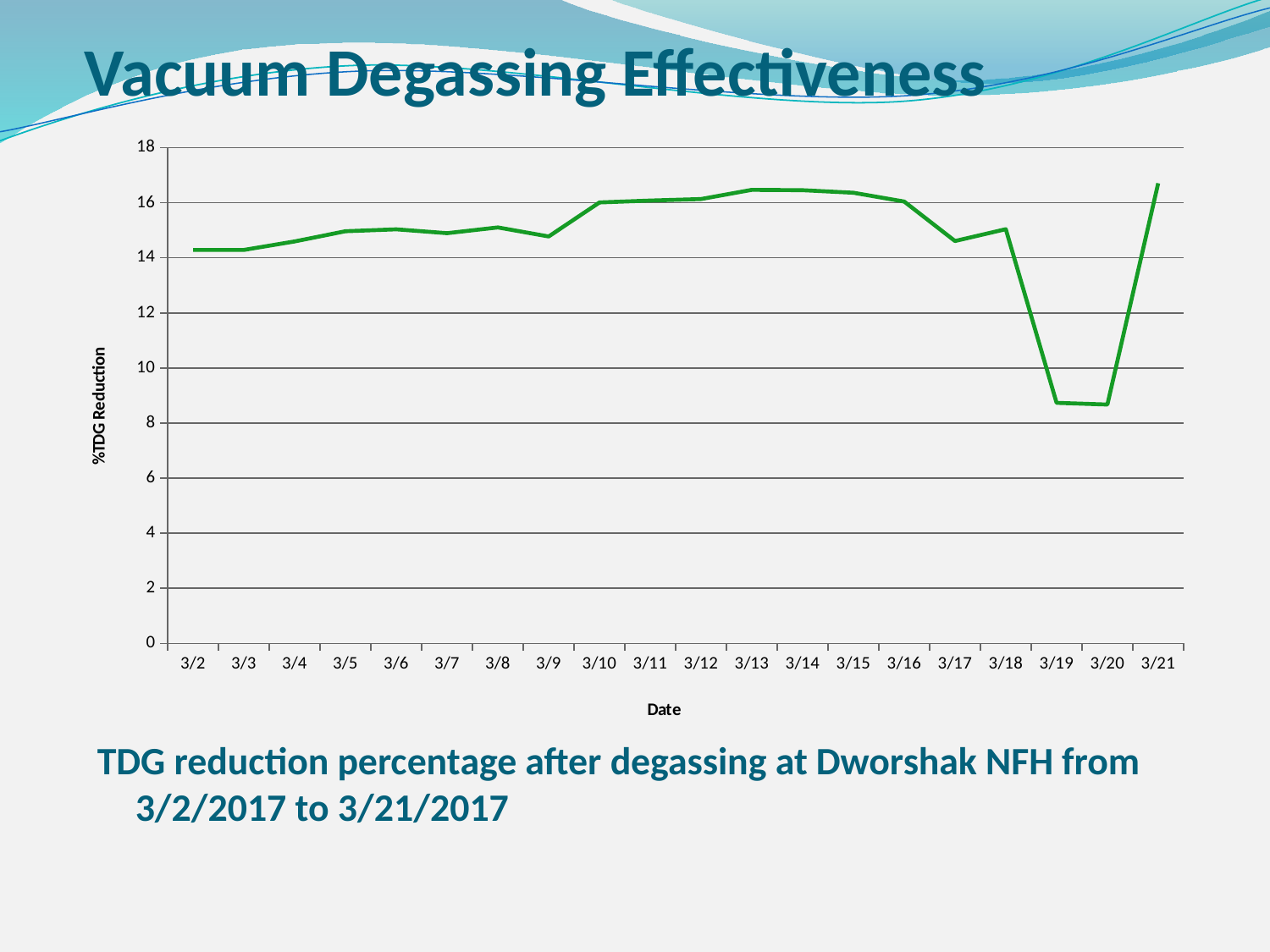
Which date has the larger value, 3/13 or 3/19? 3/13 Is the value for 3/17 greater or less than 16? less Is the value for 3/13 greater or less than 16? greater What is the label on the y axis? %TDG Reduction Do the values rise or fall from 3/16 to 3/19? fall Is the value for 3/19 greater or less than 10? less What kind of chart is shown on the slide? line chart What is the label on the x axis? Date Which date has the larger value, 3/2 or 3/10? 3/10 How many dates are plotted along the x axis? 20